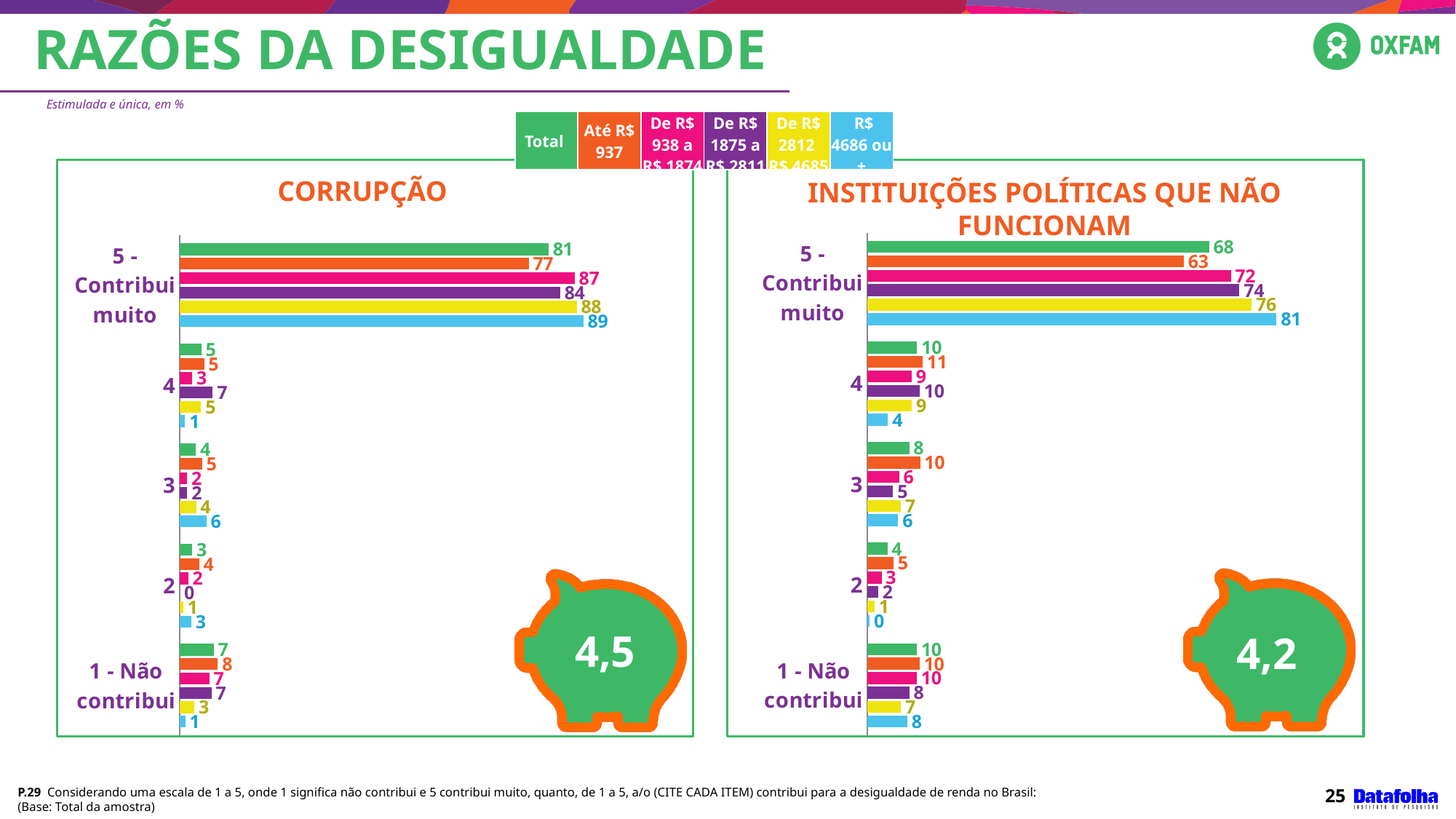
How many scale categories are shown on the y axis of the CORRUPÇÃO chart? 5 In the CORRUPÇÃO chart, what is the difference between the "R$ 4686 ou +" value and the Total value for "5 - Contribui muito"? 8 How many series does the legend list? 6 In the INSTITUIÇÕES POLÍTICAS QUE NÃO FUNCIONAM chart, which income group has the lowest value for "5 - Contribui muito"? Até R$ 937 What kind of chart is the INSTITUIÇÕES POLÍTICAS QUE NÃO FUNCIONAM chart? Bar chart In the INSTITUIÇÕES POLÍTICAS QUE NÃO FUNCIONAM chart, which is larger for "5 - Contribui muito": the Total value or the "De R$ 2812 a R$ 4685" value? De R$ 2812 a R$ 4685 In the INSTITUIÇÕES POLÍTICAS QUE NÃO FUNCIONAM chart, what is the value for "R$ 4686 ou +" at "5 - Contribui muito"? 81 In the CORRUPÇÃO chart, what is the Total value for "5 - Contribui muito"? 81 In the CORRUPÇÃO chart, which income group has the highest value for "5 - Contribui muito"? R$ 4686 ou + What average score is shown in the piggy bank icon on the CORRUPÇÃO chart? 4,5 In the INSTITUIÇÕES POLÍTICAS QUE NÃO FUNCIONAM chart, what is the Total value for "4"? 10 In the CORRUPÇÃO chart, what is the value for "Até R$ 937" at "1 - Não contribui"? 8